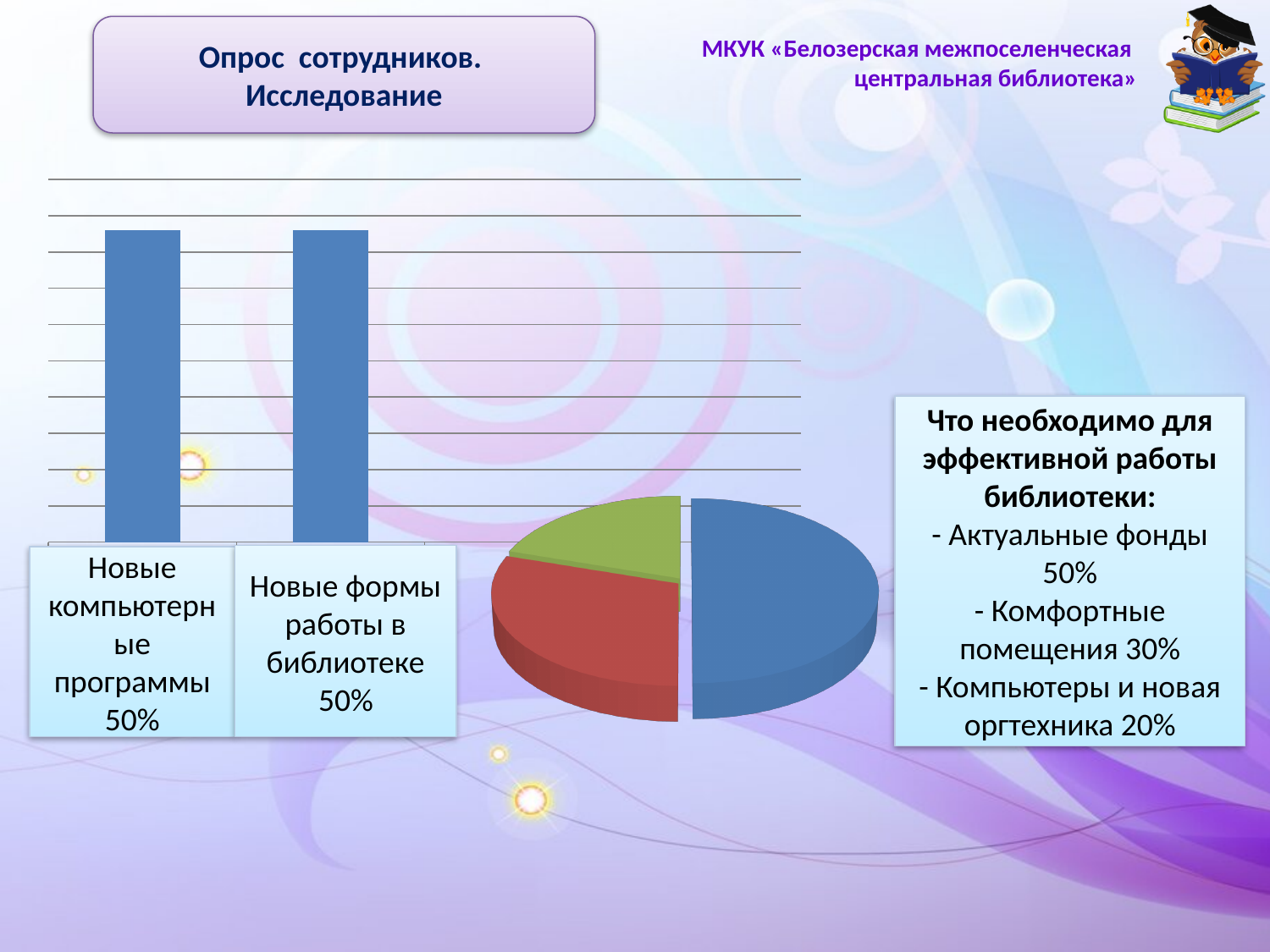
In the bar chart on the left, is the bar for 'Новые компьютерные программы' larger, smaller or equal to the bar for 'Новые формы работы в библиотеке'? equal What kind of chart is the chart on the right of the slide? pie chart What kind of chart is the chart on the left of the slide? bar chart In the pie chart on the right, which category has the largest share? Актуальные фонды How many slices does the pie chart on the right have? 3 In the pie chart on the right, which category has the smallest share? Компьютеры и новая оргтехника In the pie chart on the right, what share does 'Комфортные помещения' have? 30% In the bar chart on the left, what is the value for 'Новые формы работы в библиотеке'? 50% In the pie chart on the right, what is the difference between the shares of 'Актуальные фонды' and 'Компьютеры и новая оргтехника'? 30% In the pie chart on the right, what colour is the largest slice? blue How many bars does the bar chart on the left show? 2 In the bar chart on the left, what is the value for 'Новые компьютерные программы'? 50%